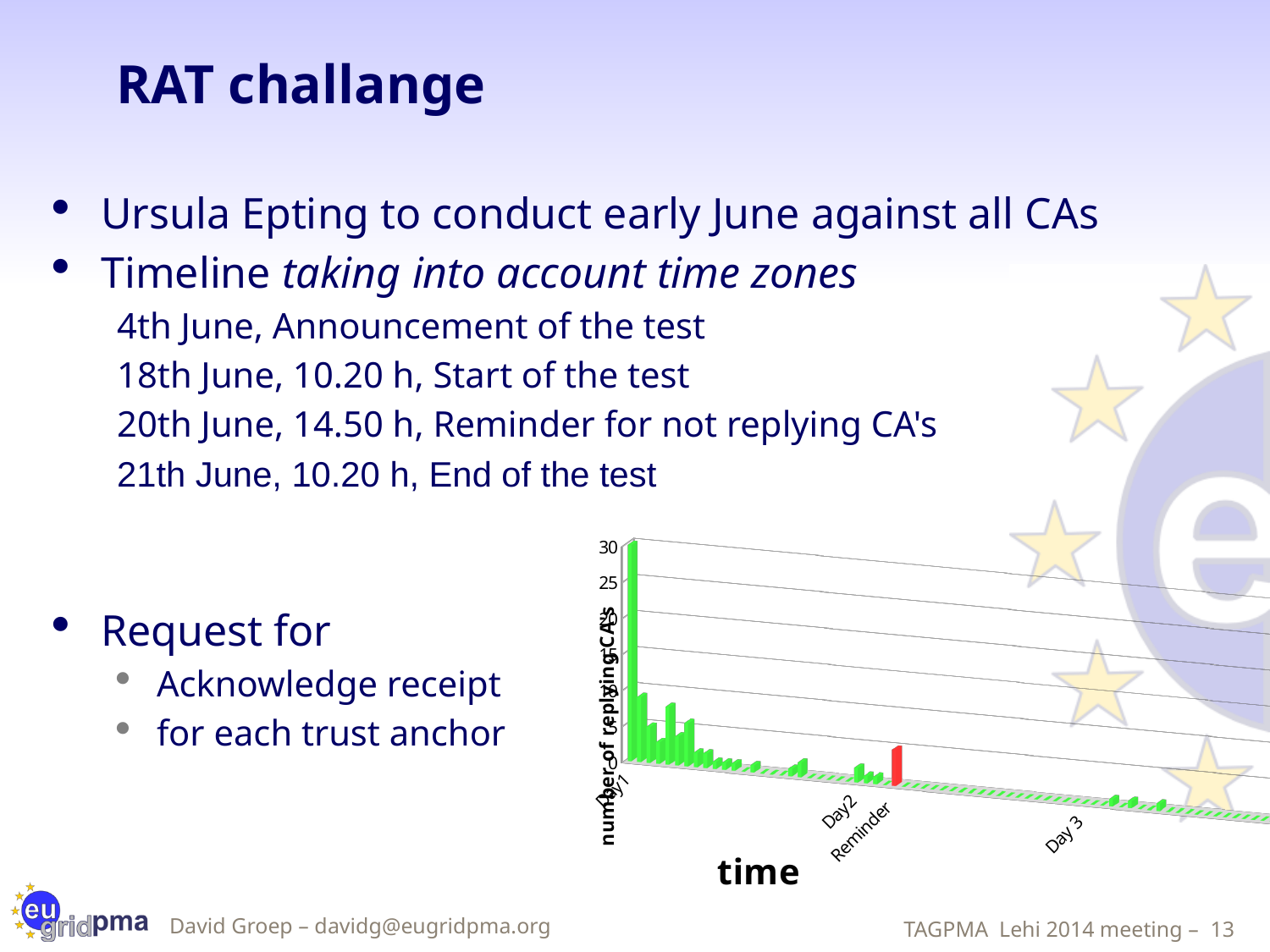
What is the highest tick value shown on the vertical axis? 30 Is the value of the red bar at the Reminder greater or less than 10? less What kind of chart is shown on the slide? bar chart Are the bars in Day 3 greater or less than 5? less What is the title of the vertical axis of the chart? number of replying CA's Do the bar values generally rise or fall along the time axis from Day 1 to Day 3? fall Which labelled period on the time axis contains the tallest bar? Day 1 What is the title of the horizontal axis of the chart? time How many labels are shown along the time axis? 4 Is the value of the tallest bar at the start of Day 1 greater or less than 25? greater